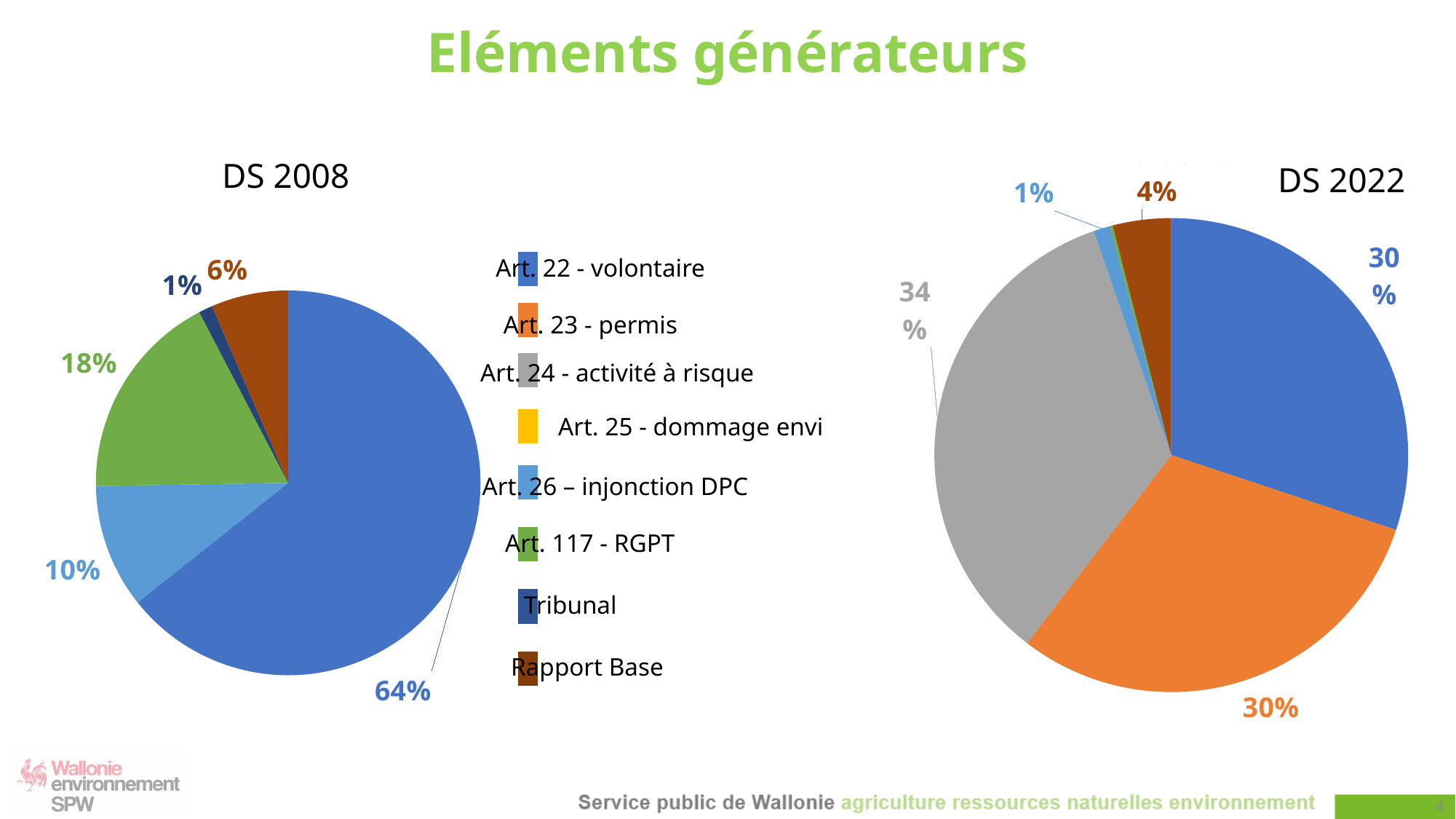
In the DS 2008 chart, what share does Art. 117 - RGPT have? 18% In the DS 2022 chart, what share does Art. 24 - activité à risque have? 34% In the DS 2022 chart, which category has the largest slice? Art. 24 - activité à risque What type of chart is the DS 2008 chart? pie chart How many entries does the legend list? 8 In the DS 2008 chart, which category has the largest slice? Art. 22 - volontaire In the DS 2008 chart, what share does Rapport Base have? 6% In the DS 2022 chart, which is larger: the share of Art. 23 - permis or the share of Rapport Base? Art. 23 - permis In the DS 2008 chart, what share does Art. 22 - volontaire have? 64% In the DS 2022 chart, what share does Rapport Base have? 4% In the DS 2008 chart, what is the difference between the shares of Art. 117 - RGPT and Art. 26 – injonction DPC? 8% In the DS 2008 chart, what share does Art. 26 – injonction DPC have? 10%